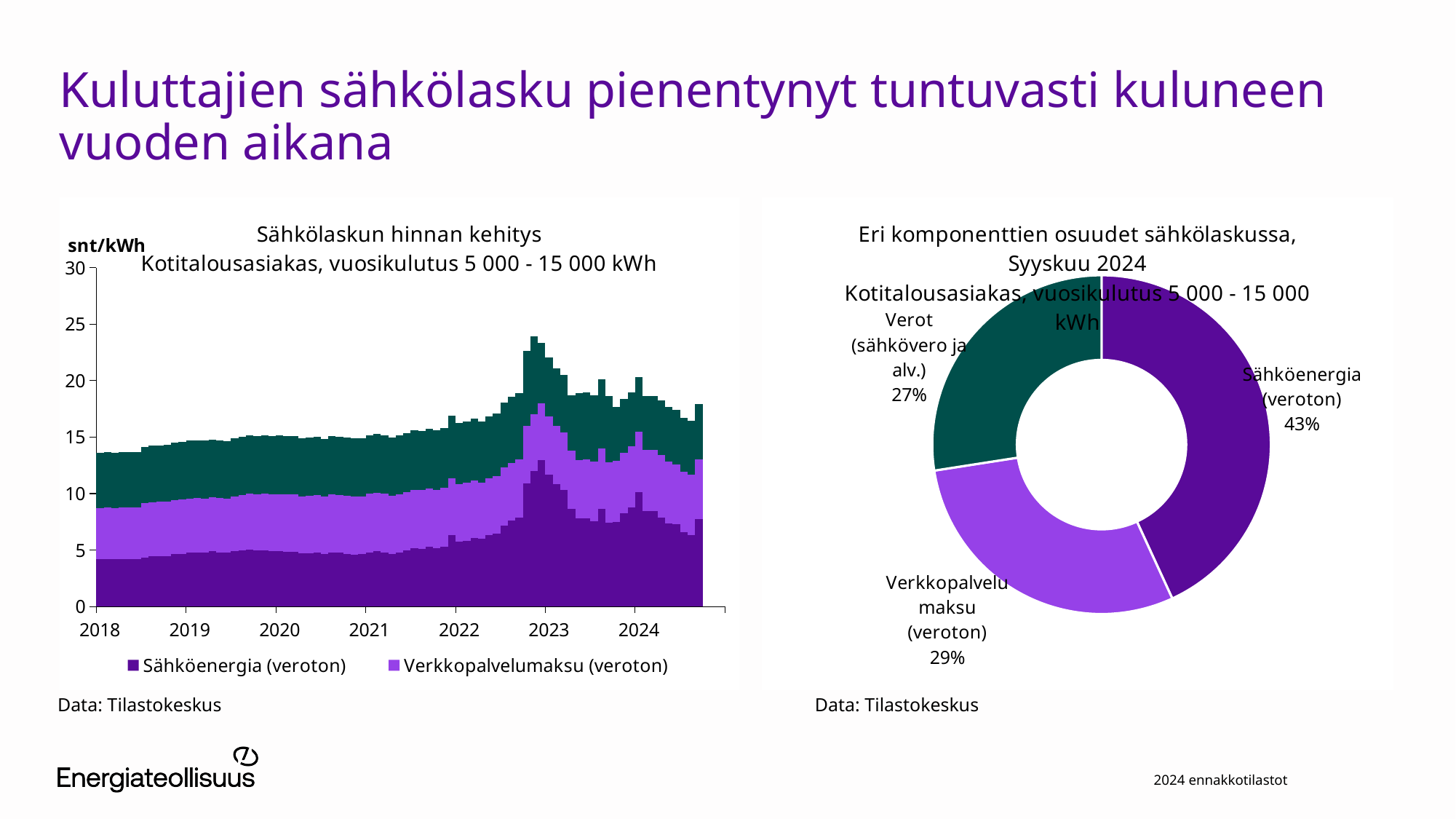
In the donut chart on the right, which is larger: the share of Verkkopalvelumaksu or the share of Verot? Verkkopalvelumaksu (veroton) In the chart on the left, is the total price at the start of 2018 greater or less than 15 snt/kWh? less In the donut chart on the right, which component has the largest share? Sähköenergia (veroton) In the donut chart on the right, which component has the smallest share? Verot (sähkövero ja alv.) In the donut chart on the right, what is the difference in percentage points between the Sähköenergia share and the Verot share? 16 percentage points In the donut chart on the right, what share do Verot (sähkövero ja alv.) have? 27% What kind of chart is the chart on the left, 'Sähkölaskun hinnan kehitys'? Stacked bar chart How many series does the legend of the chart on the left list? 2 In the donut chart 'Eri komponenttien osuudet sähkölaskussa', what share does Sähköenergia (veroton) have? 43% In the donut chart on the right, what share does Verkkopalvelumaksu (veroton) have? 29% In the chart on the left, is the highest total price reached around the end of 2022 greater or less than 20 snt/kWh? greater How many components are shown in the donut chart on the right? 3